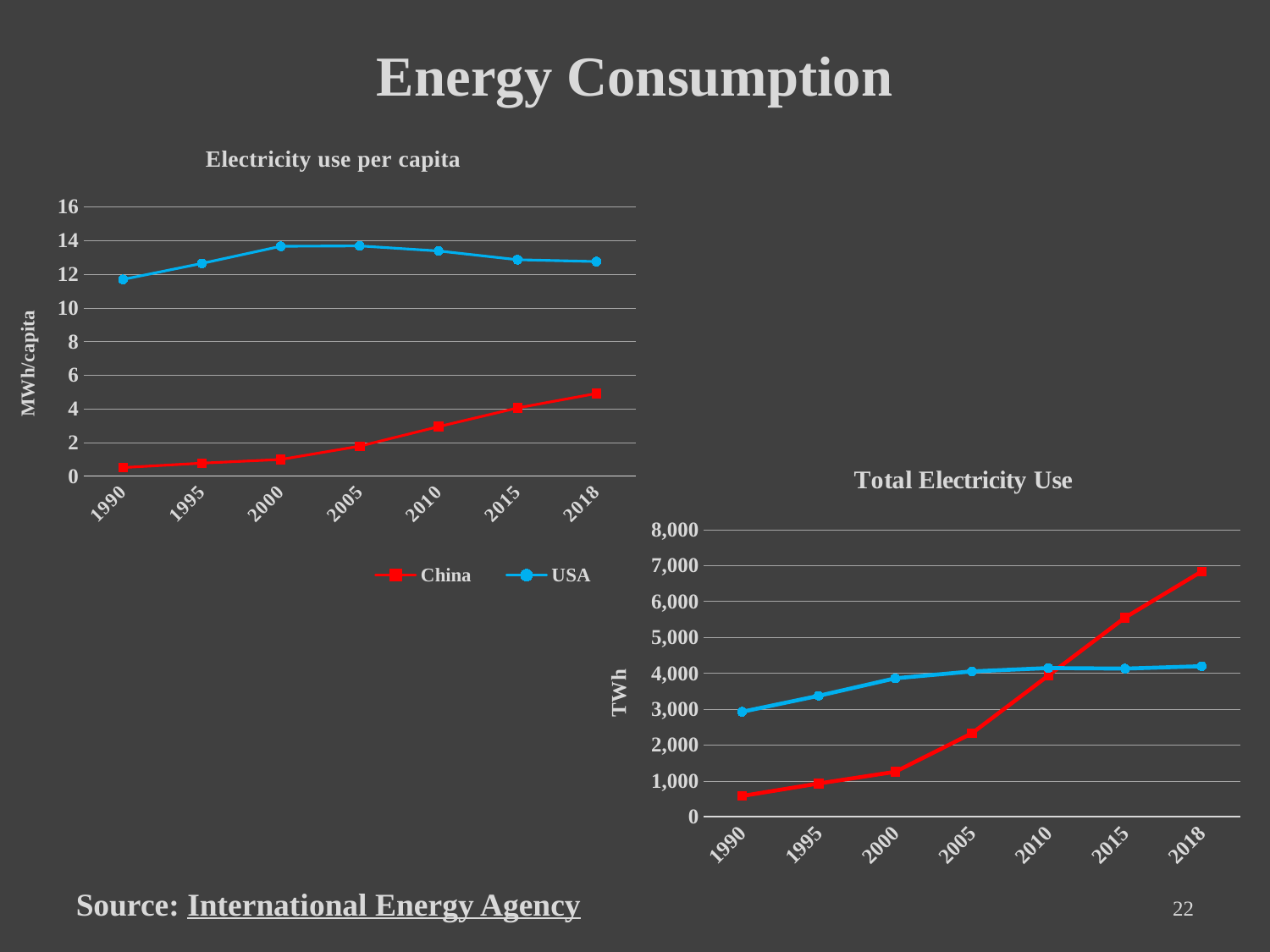
In the 'Electricity use per capita' chart, is the value for USA in 2000 greater or less than 12? greater In the 'Electricity use per capita' chart, in which year is the China value highest? 2018 In the 'Electricity use per capita' chart, is the value for China in 2018 greater or less than 6? less In the 'Electricity use per capita' chart, which series is higher in 2010, China or USA? USA In the 'Total Electricity Use' chart, which series is higher in 2015, China or USA? China How many series does the legend of the 'Electricity use per capita' chart list? 2 In the 'Total Electricity Use' chart, is the value for China in 2018 greater or less than 6,000? greater In the 'Electricity use per capita' chart, does the China series rise or fall from 1990 to 2018? rise What kind of chart is the 'Electricity use per capita' chart? line chart How many years are plotted on the x axis of the 'Total Electricity Use' chart? 7 What unit is shown on the y axis of the 'Total Electricity Use' chart? TWh